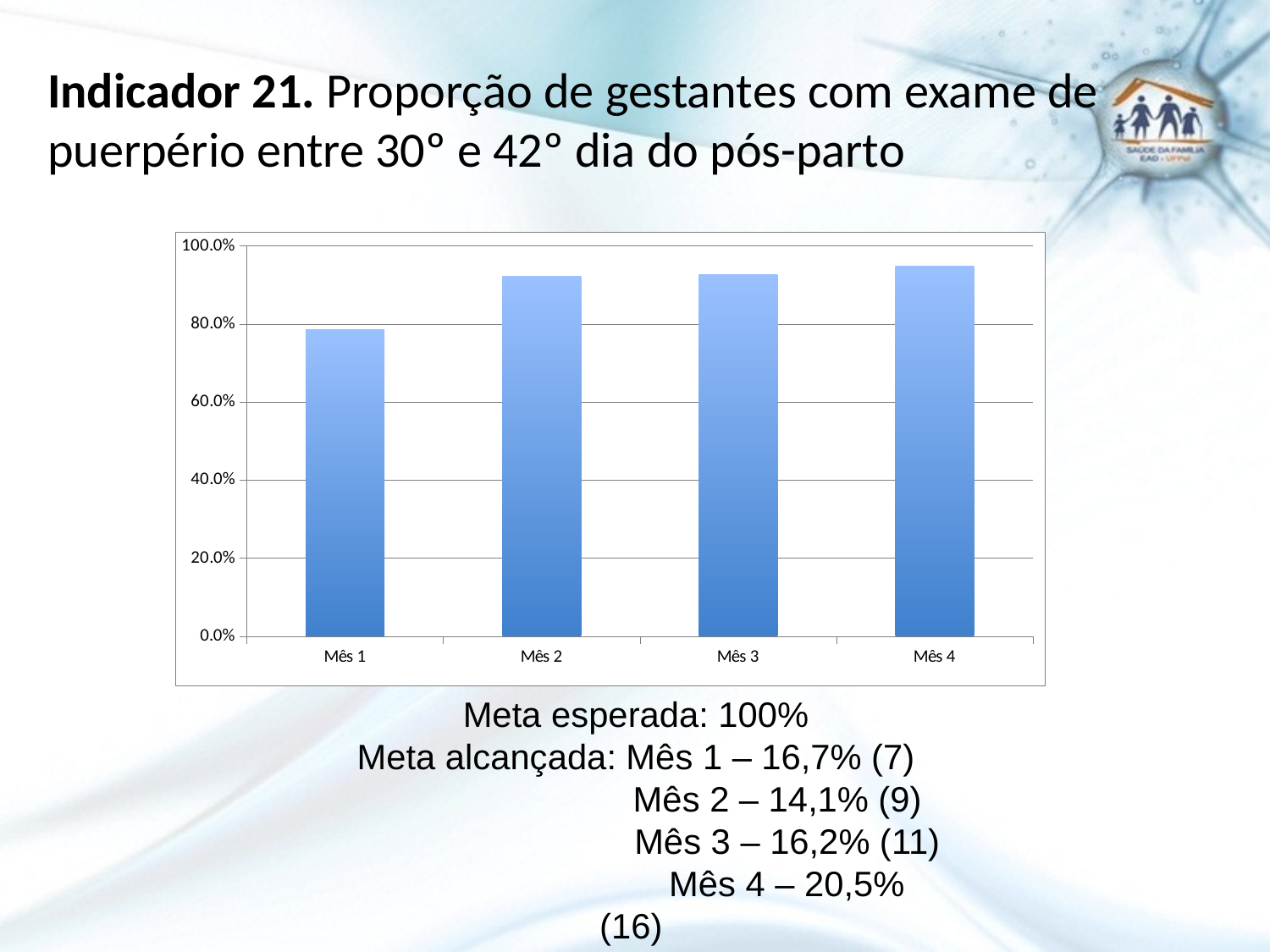
Which month has the lowest bar? Mês 1 Is the value for Mês 2 greater or less than 80.0%? greater Is the value for Mês 1 greater or less than 60.0%? greater What is the highest tick label shown on the y axis? 100.0% How many categories (months) are plotted on the x axis? 4 What kind of chart is shown on the slide? bar chart Is the value for Mês 4 greater or less than 100.0%? less Which is larger, the value for Mês 1 or the value for Mês 4? Mês 4 Which month has the highest bar? Mês 4 Which is larger, the value for Mês 1 or the value for Mês 2? Mês 2 Do the bar values generally rise or fall from Mês 1 to Mês 4? rise